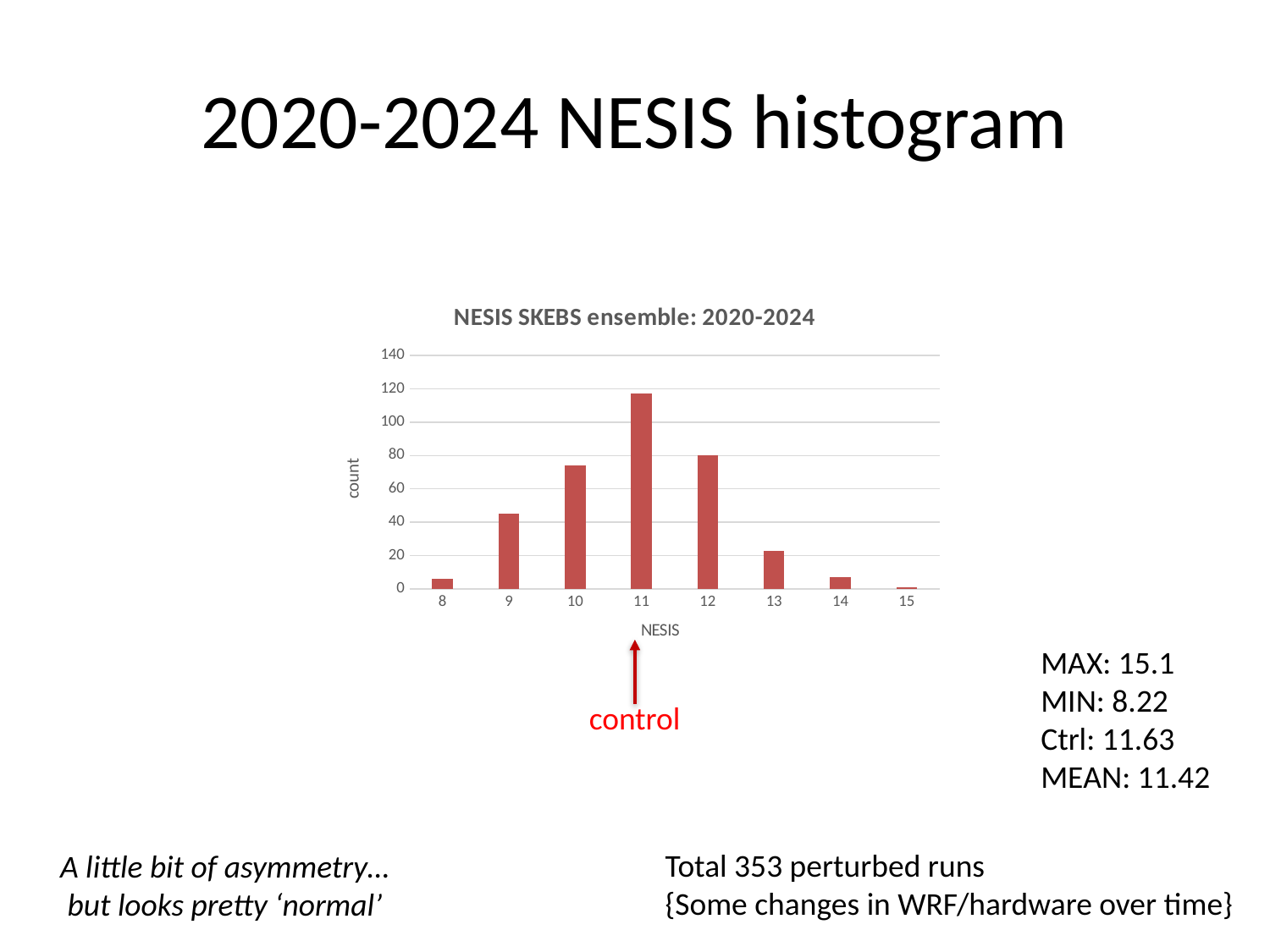
Which NESIS category has the lowest count? 15 What kind of chart is shown on the slide? bar chart What is the label of the y axis of the chart? count Which has a higher count, NESIS 10 or NESIS 12? 12 Is the count for NESIS 9 greater or less than 60? less Is the count for NESIS 10 greater or less than 60? greater Which has a higher count, NESIS 9 or NESIS 13? 9 Which NESIS category has the highest count? 11 What is the title of the chart? NESIS SKEBS ensemble: 2020-2024 Is the count for NESIS 11 greater or less than 100? greater How many NESIS categories are shown on the x axis of the chart? 8